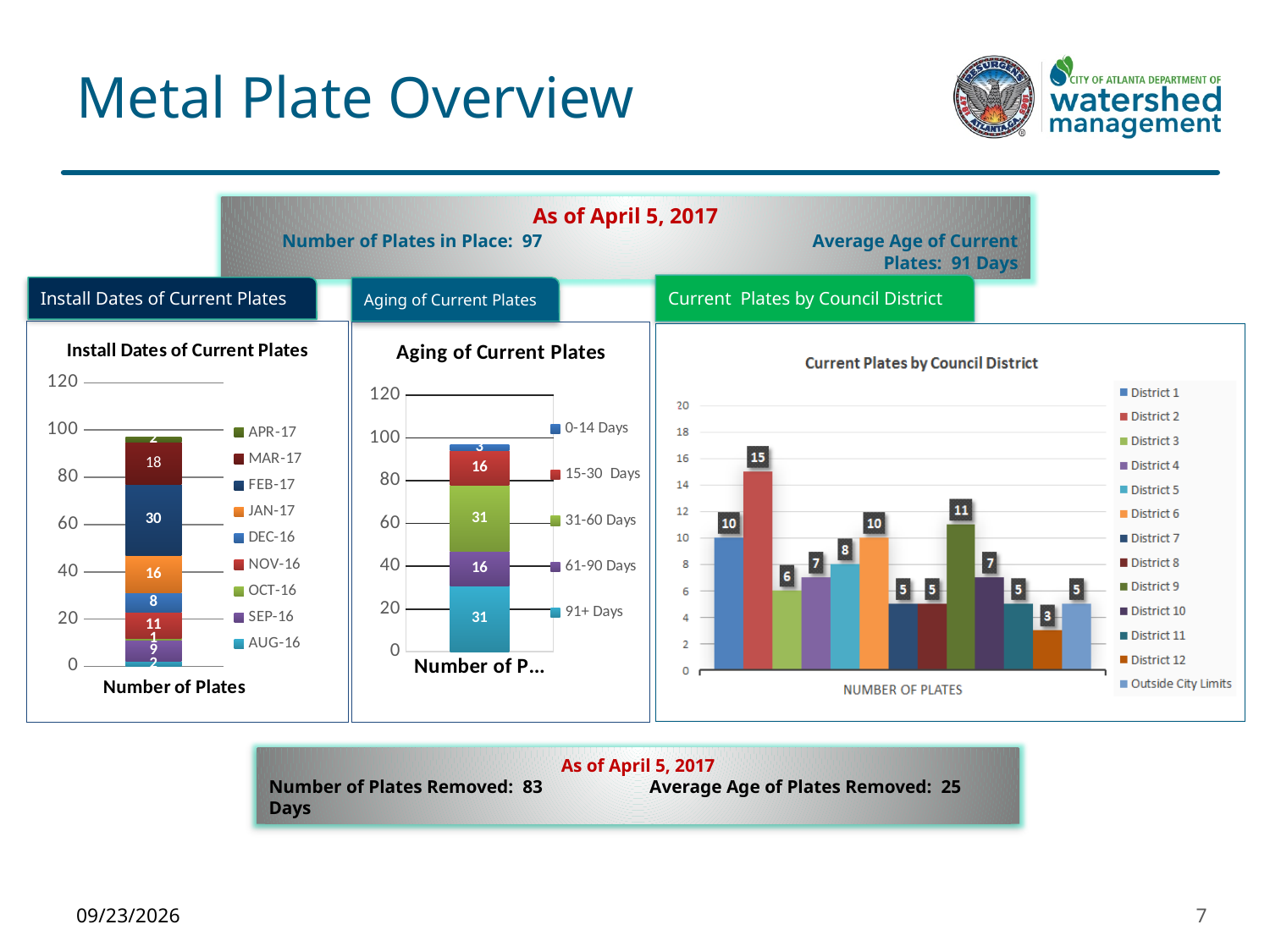
In the Install Dates of Current Plates chart, what is the difference between the MAR-17 and JAN-17 values? 2 In the Current Plates by Council District chart, which district has the lowest number of plates? District 12 In the Current Plates by Council District chart, how many plates does District 2 have? 15 In the Aging of Current Plates chart, what is the total of the stacked bar? 97 In the Current Plates by Council District chart, which district has the highest number of plates? District 2 In the Install Dates of Current Plates chart, how many plates were installed in FEB-17? 30 In the Current Plates by Council District chart, which has more plates, District 1 or District 3? District 1 In the Current Plates by Council District chart, what is the difference between the number of plates in District 9 and District 12? 8 In the Aging of Current Plates chart, which age category has the fewest plates? 0-14 Days What kind of chart is the Install Dates of Current Plates chart? Stacked bar chart In the Aging of Current Plates chart, how many plates are in the 31-60 Days category? 31 How many entries does the legend of the Current Plates by Council District chart list? 13